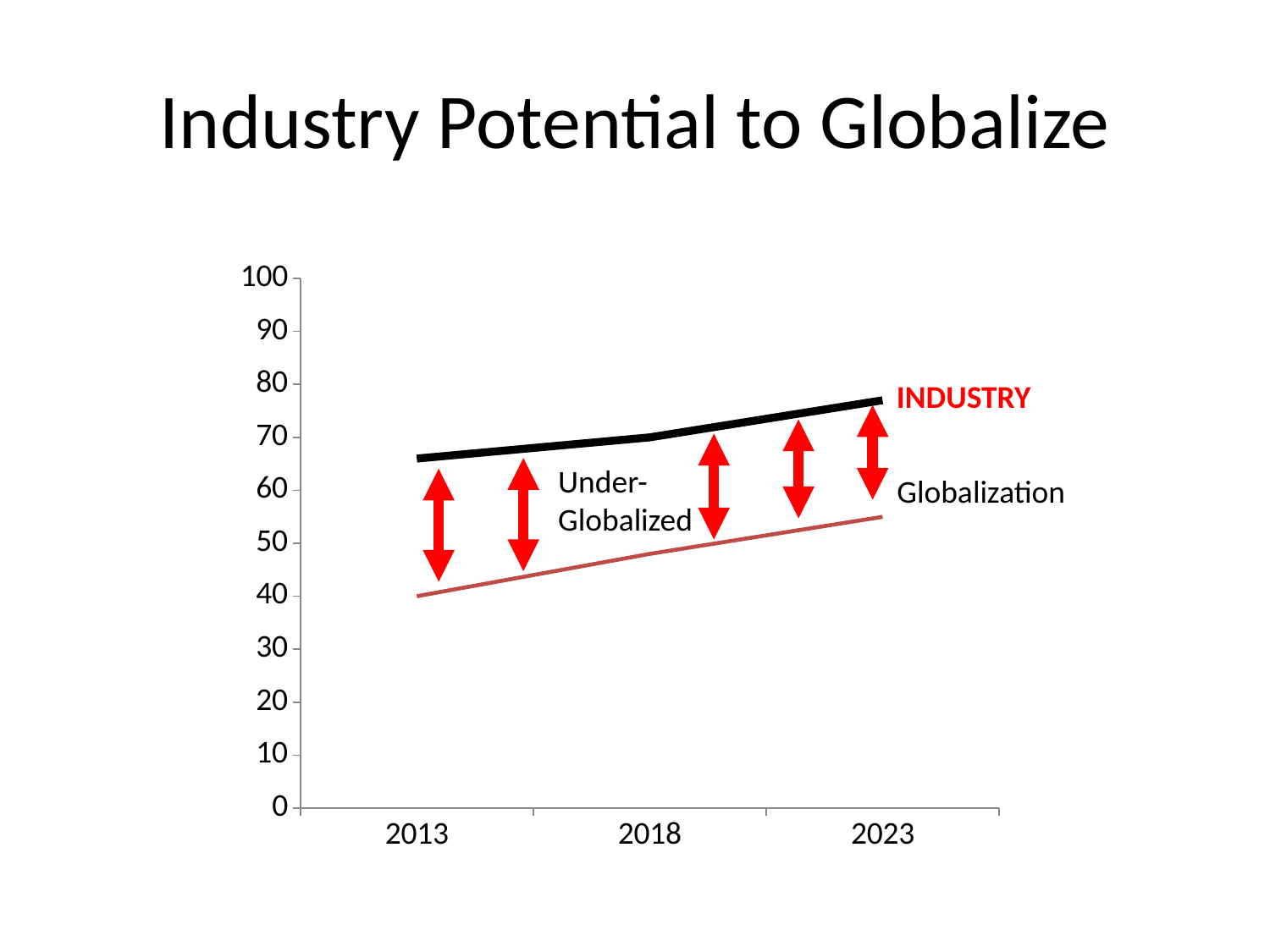
What is the title of the slide? Industry Potential to Globalize Is the INDUSTRY value in 2013 greater or less than 60? greater In 2018, which line is higher, INDUSTRY or Globalization? INDUSTRY Does the Globalization line rise or fall from 2013 to 2023? rise Is the INDUSTRY value in 2023 greater or less than 80? less What label is written in the gap between the INDUSTRY and Globalization lines? Under-Globalized Does the INDUSTRY line rise or fall from 2013 to 2023? rise What kind of chart is shown on the slide? line chart How many years are labelled on the x axis? 3 Is the Globalization value in 2023 greater or less than 50? greater In which year is the INDUSTRY line at its highest? 2023